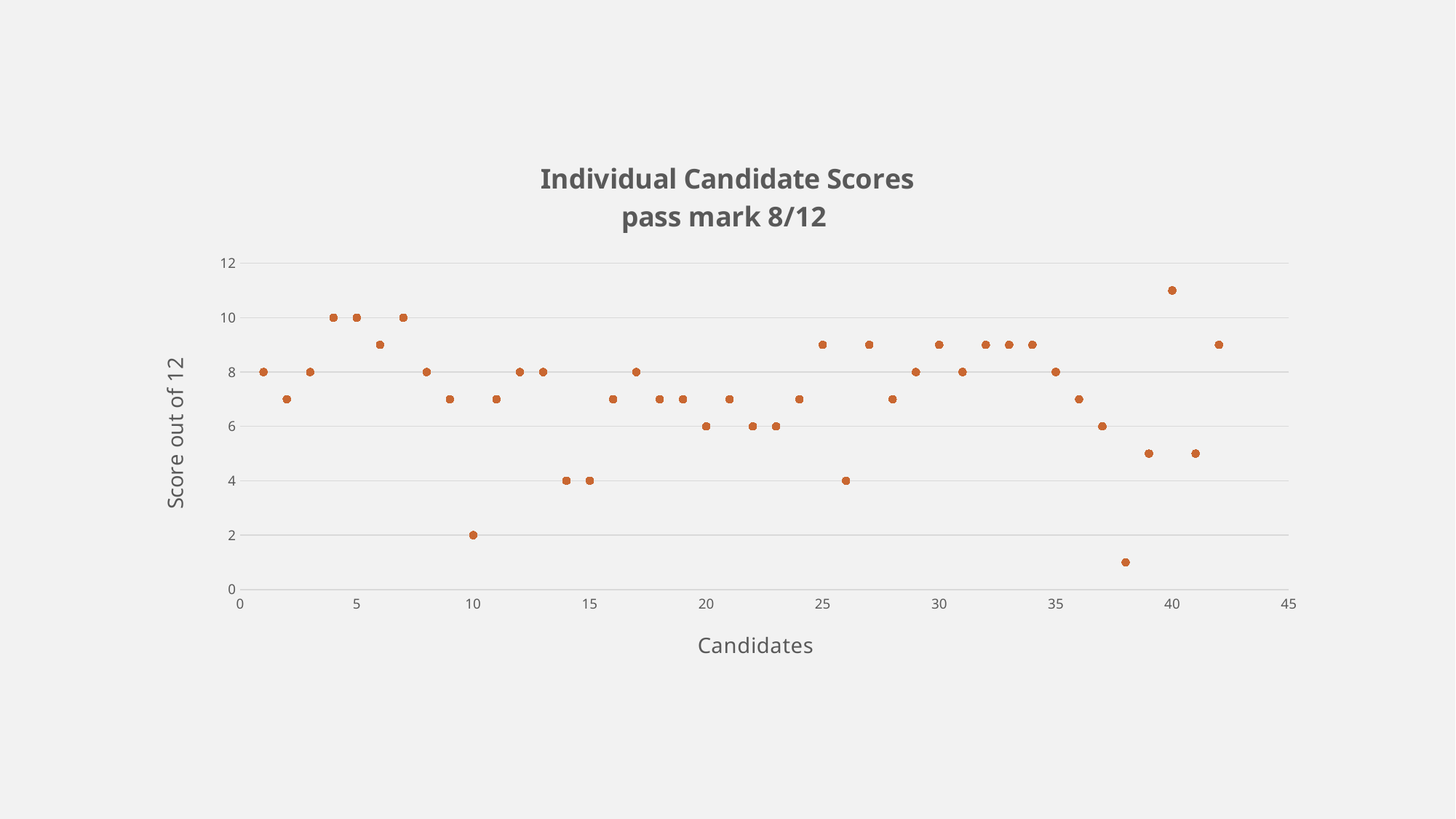
Is the score for candidate 40 greater or less than 10? greater What is the score of candidate 14? 4 What is the score of candidate 10? 2 Which candidate has the lowest score? 38 Which candidate has the highest score? 40 What is the title of the chart? Individual Candidate Scores pass mark 8/12 How many candidate points are plotted on the chart? 42 What is the label of the vertical axis? Score out of 12 What is the score of candidate 20? 6 What kind of chart is shown on the slide? scatter chart Is the score for candidate 38 greater or less than 2? less What is the score of candidate 4? 10